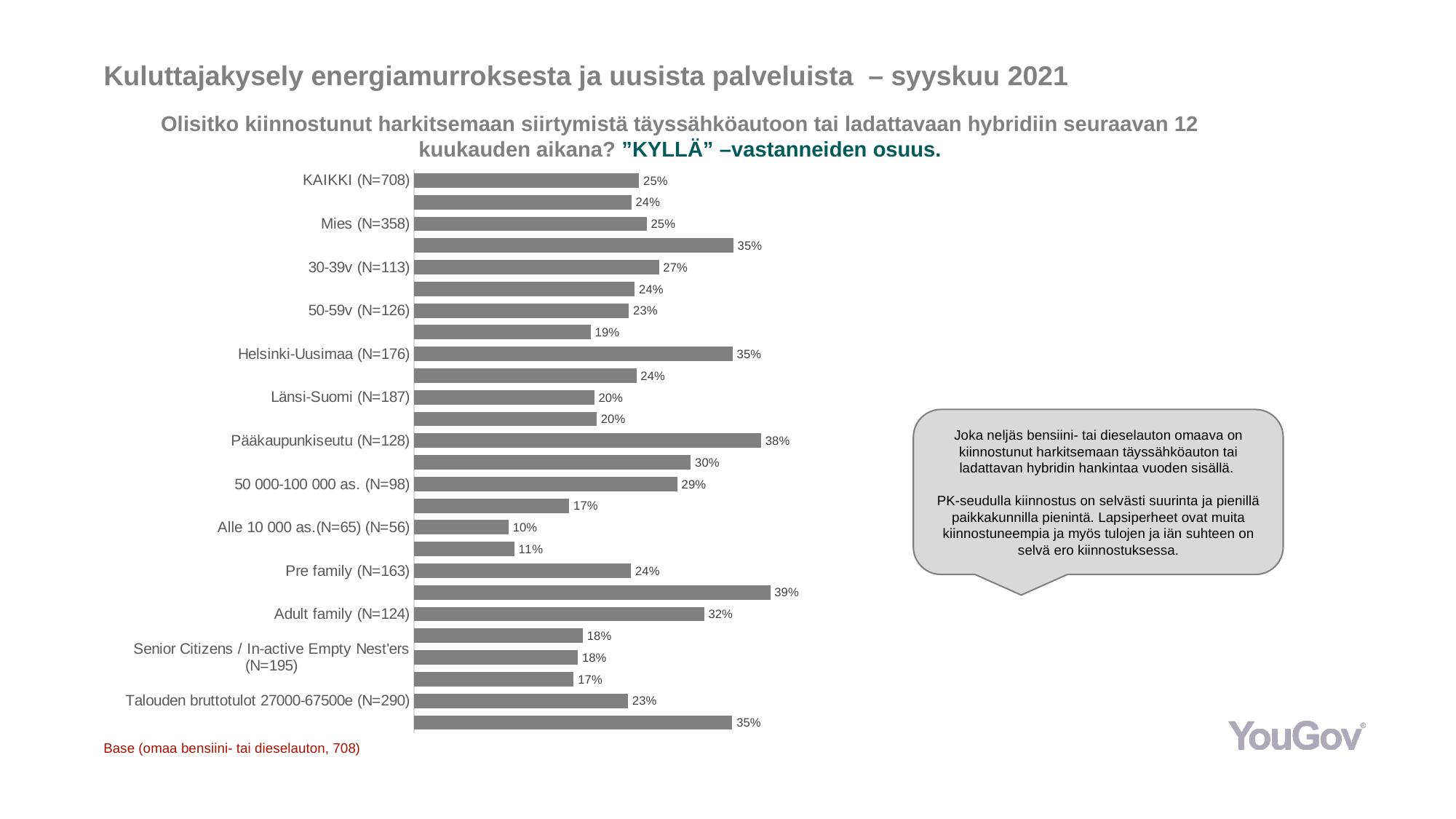
What is the value for Alle 10 000 as.(N=65) (N=56)? 10% What is the value for Pääkaupunkiseutu (N=128)? 38% Which labelled category has the lowest value? Alle 10 000 as.(N=65) (N=56) Which is larger, the value for Helsinki-Uusimaa (N=176) or the value for Länsi-Suomi (N=187)? Helsinki-Uusimaa (N=176) What is the value for Adult family (N=124)? 32% How many bars are plotted in the chart? 26 What is the value for Senior Citizens / In-active Empty Nest'ers (N=195)? 18% What kind of chart is shown on the slide? bar chart What is the difference between the values for Pääkaupunkiseutu (N=128) and Alle 10 000 as.(N=65) (N=56)? 28 percentage points What is the value for Helsinki-Uusimaa (N=176)? 35% What is the value for KAIKKI (N=708)? 25% What is the base noted below the chart? Base (omaa bensiini- tai dieselauton, 708)